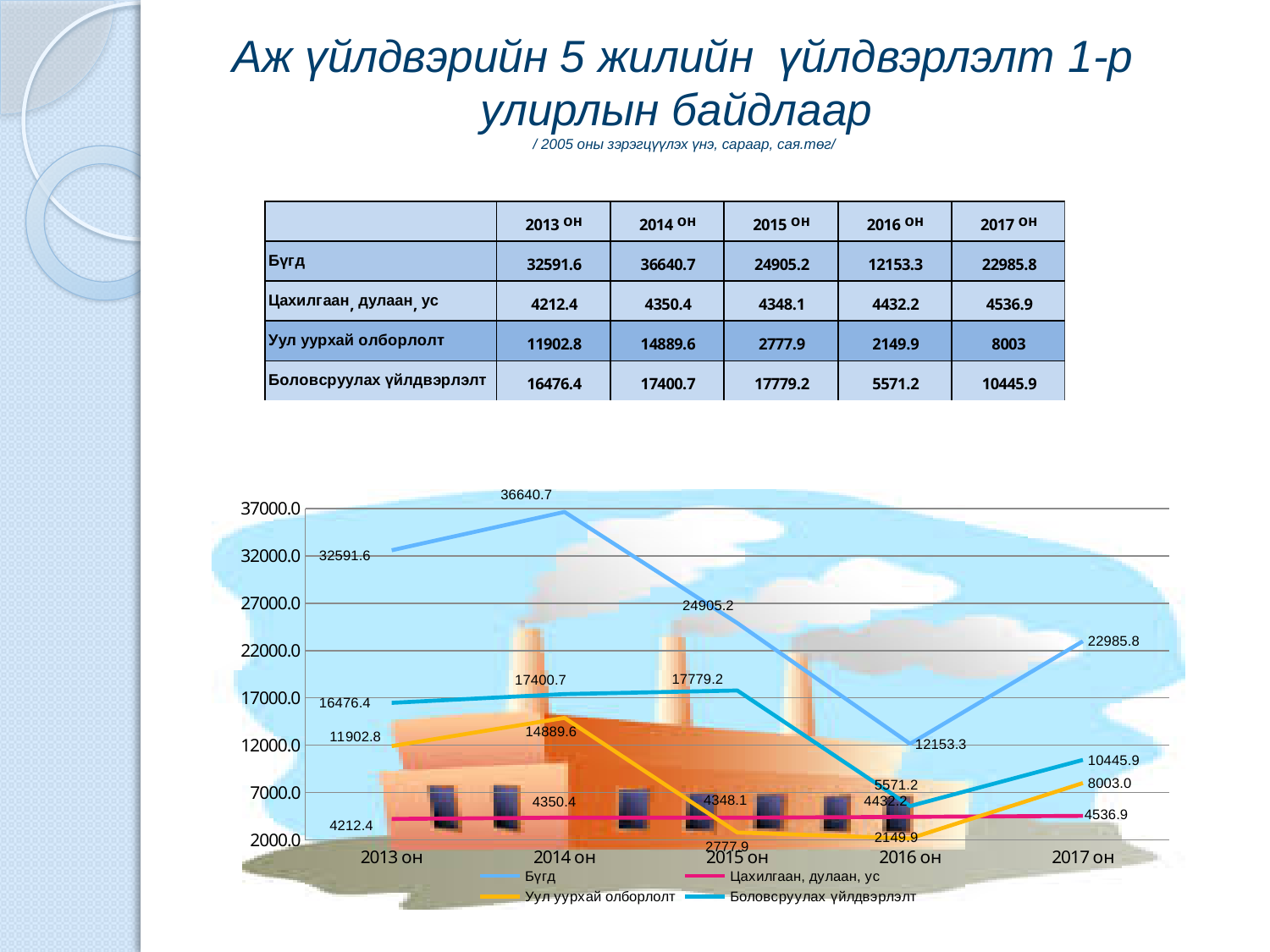
What is the value of Уул уурхай олборлолт for 2017 он in the chart? 8003.0 What colour is the Бүгд line in the chart legend? light blue Does the Бүгд series rise or fall from 2014 он to 2016 он? fall How many series does the chart legend list? 4 What is the difference between the Боловсруулах үйлдвэрлэлт values for 2015 он and 2016 он? 12208.0 How many years are plotted along the x axis of the chart? 5 What is the value of Бүгд for 2014 он in the chart? 36640.7 In which year does the Бүгд series reach its highest value? 2014 он What kind of chart is shown on the slide? line chart In which year is the Уул уурхай олборлолт series at its lowest? 2016 он In 2013 он, which is larger: Уул уурхай олборлолт or Боловсруулах үйлдвэрлэлт? Боловсруулах үйлдвэрлэлт Is the value of Бүгд for 2017 он greater or less than 22000? greater